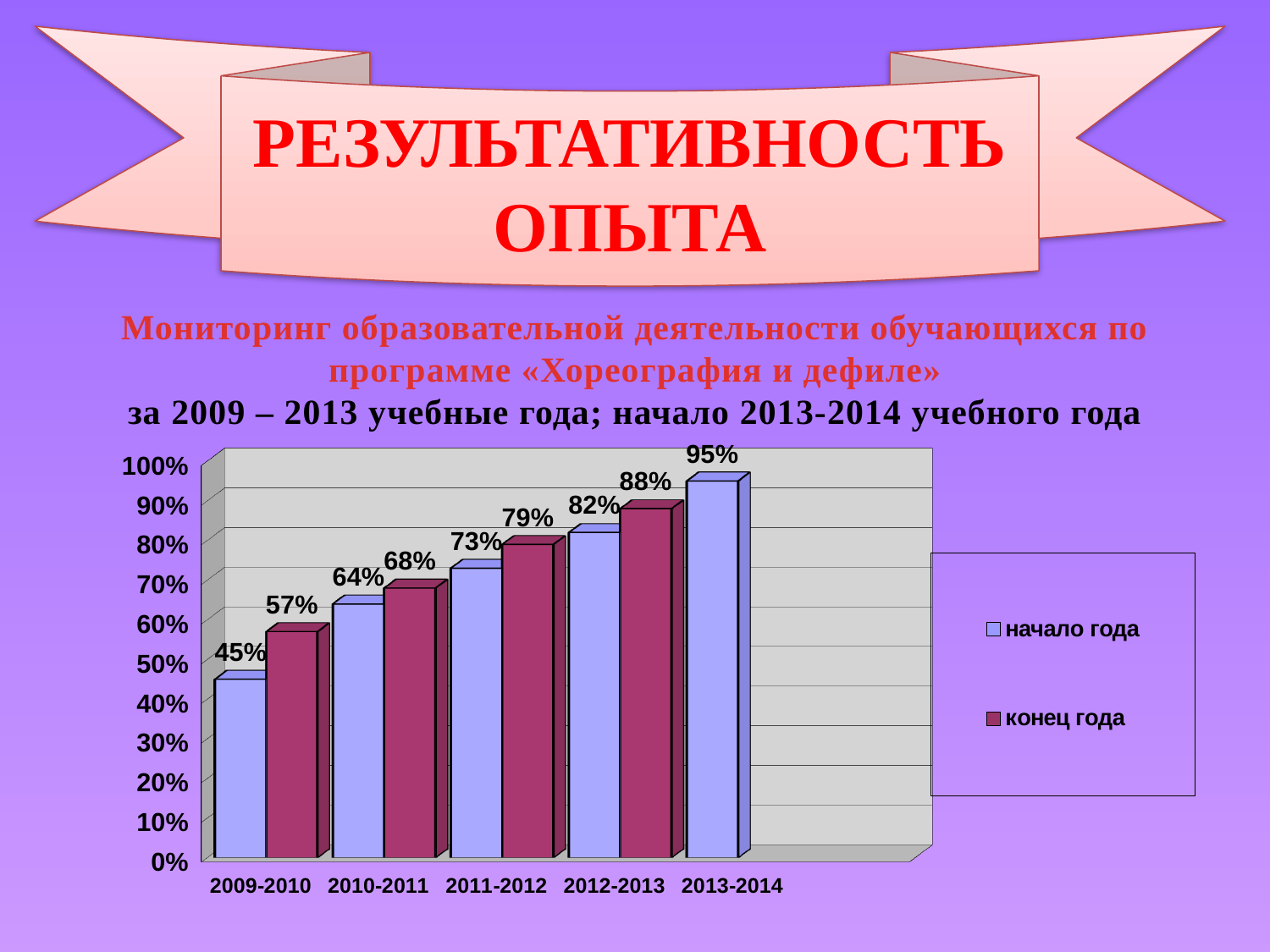
Which is larger: "конец года" in 2010-2011 or "начало года" in 2011-2012? начало года in 2011-2012 What is the difference between "начало года" in 2013-2014 and "начало года" in 2012-2013? 13% Which year has the highest value for "конец года"? 2012-2013 How many year categories are shown on the x axis? 5 What is the value for "конец года" in 2011-2012? 79% Which year has the lowest value for "начало года"? 2009-2010 What is the value for "начало года" in 2009-2010? 45% What is the value for "начало года" in 2013-2014? 95% Do the "начало года" values rise or fall from 2009-2010 to 2013-2014? rise What kind of chart is shown on the slide? bar chart What is the difference between "конец года" and "начало года" in 2009-2010? 12% How many series does the legend list? 2